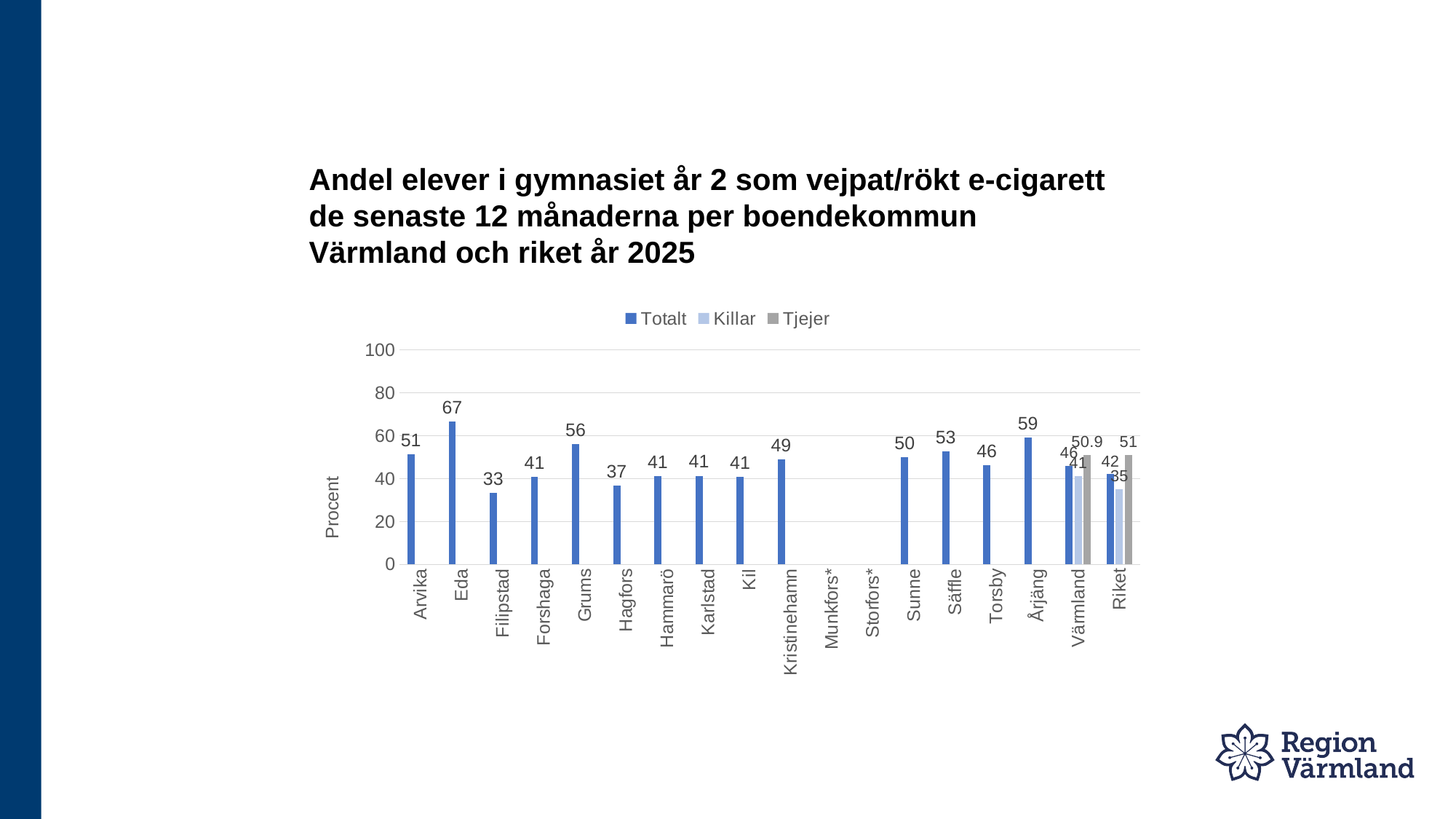
How many series does the legend list? 3 What is the Tjejer value for Värmland? 50.9 What is the difference between the Totalt values for Eda and Filipstad? 34 How many categories are shown on the x axis? 18 What is the Totalt value for Eda? 67 Which has a higher Totalt value, Grums or Årjäng? Årjäng What kind of chart is shown on the slide? Bar chart What is the label on the y axis? Procent What is the difference between the Tjejer and Killar values for Riket? 16 What is the Killar value for Riket? 35 Which municipality has the highest Totalt value? Eda Which municipality has the lowest Totalt value among those with a plotted bar? Filipstad